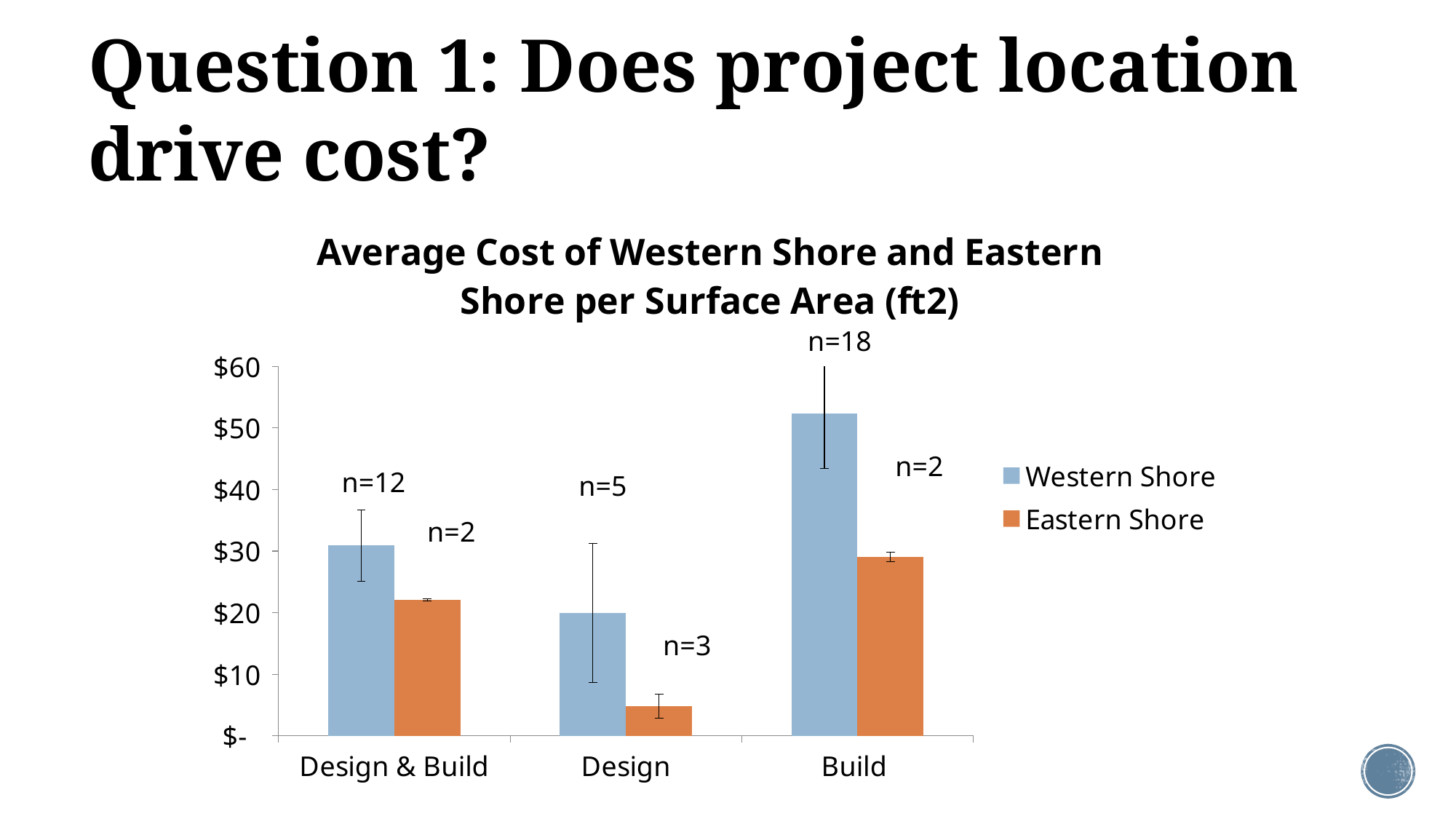
What kind of chart is shown on the slide? bar chart For Design, which is larger: Western Shore or Eastern Shore? Western Shore Which category has the lowest Eastern Shore bar? Design What is the title of the chart? Average Cost of Western Shore and Eastern Shore per Surface Area (ft2) How many project categories are shown on the x axis? 3 Is the Western Shore value for Build greater or less than $40? greater Which category has the highest Western Shore bar? Build Is the Eastern Shore value for Design greater or less than $10? less Is the Western Shore value for Design & Build greater or less than $20? greater How many series does the legend list? 2 For Build, which is larger: Western Shore or Eastern Shore? Western Shore What is the sample size (n) shown above the Western Shore bar for Build? n=18